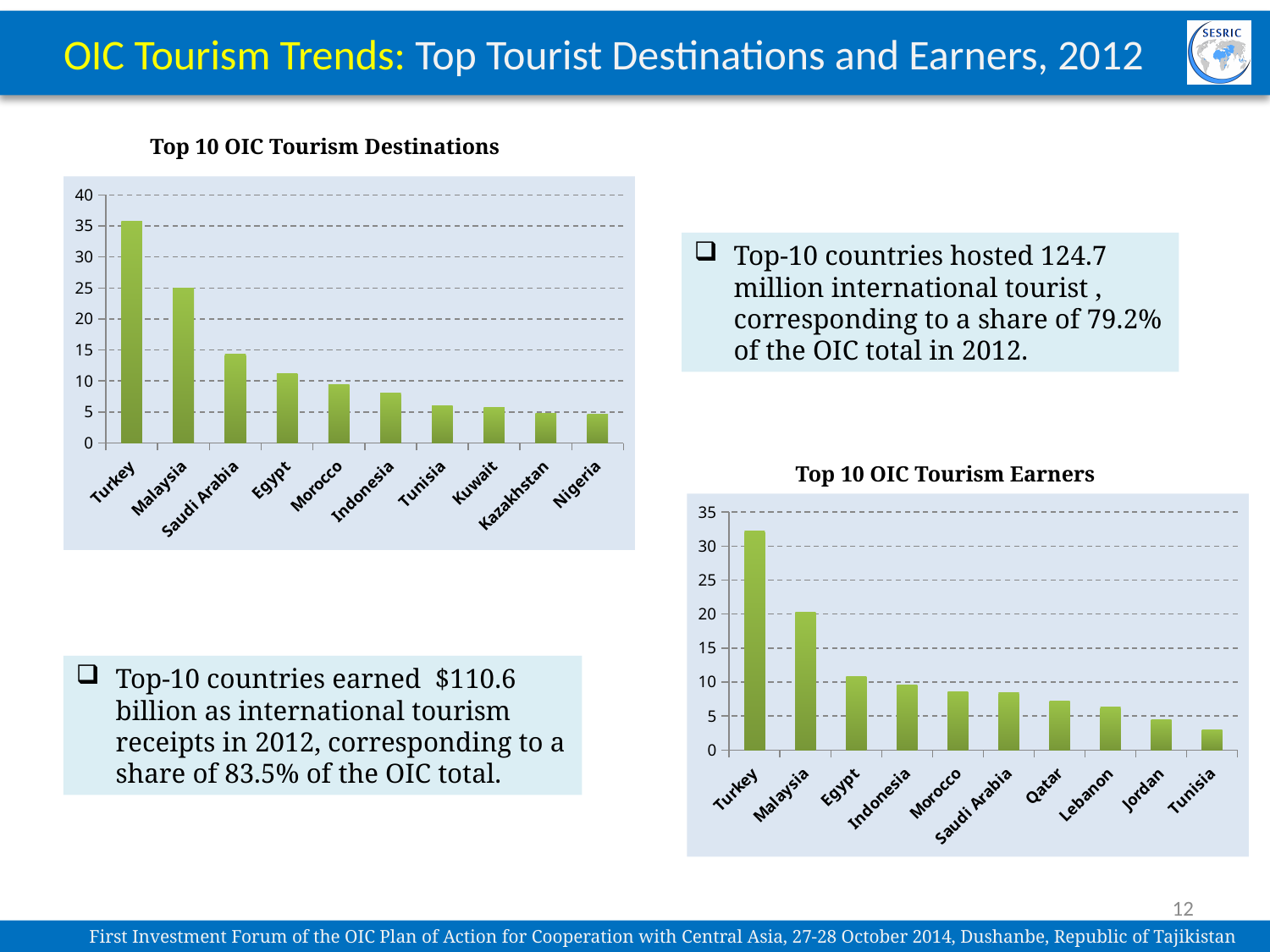
In the Top 10 OIC Tourism Destinations chart, is the value for Saudi Arabia greater or less than 20? less In the Top 10 OIC Tourism Earners chart, which country has the highest value? Turkey In the Top 10 OIC Tourism Earners chart, which country has the lowest value? Tunisia In the Top 10 OIC Tourism Earners chart, is the value for Qatar greater or less than 5? greater How many countries are shown in the Top 10 OIC Tourism Destinations chart? 10 In the Top 10 OIC Tourism Earners chart, do the values rise or fall from left to right along the x axis? fall In the Top 10 OIC Tourism Destinations chart, is the value for Turkey greater or less than 30? greater What kind of chart is the Top 10 OIC Tourism Earners chart? bar chart In the Top 10 OIC Tourism Destinations chart, is the value for Malaysia larger than the value for Egypt? Yes In the Top 10 OIC Tourism Destinations chart, which country has the lowest value? Nigeria In the Top 10 OIC Tourism Destinations chart, which country has the highest value? Turkey